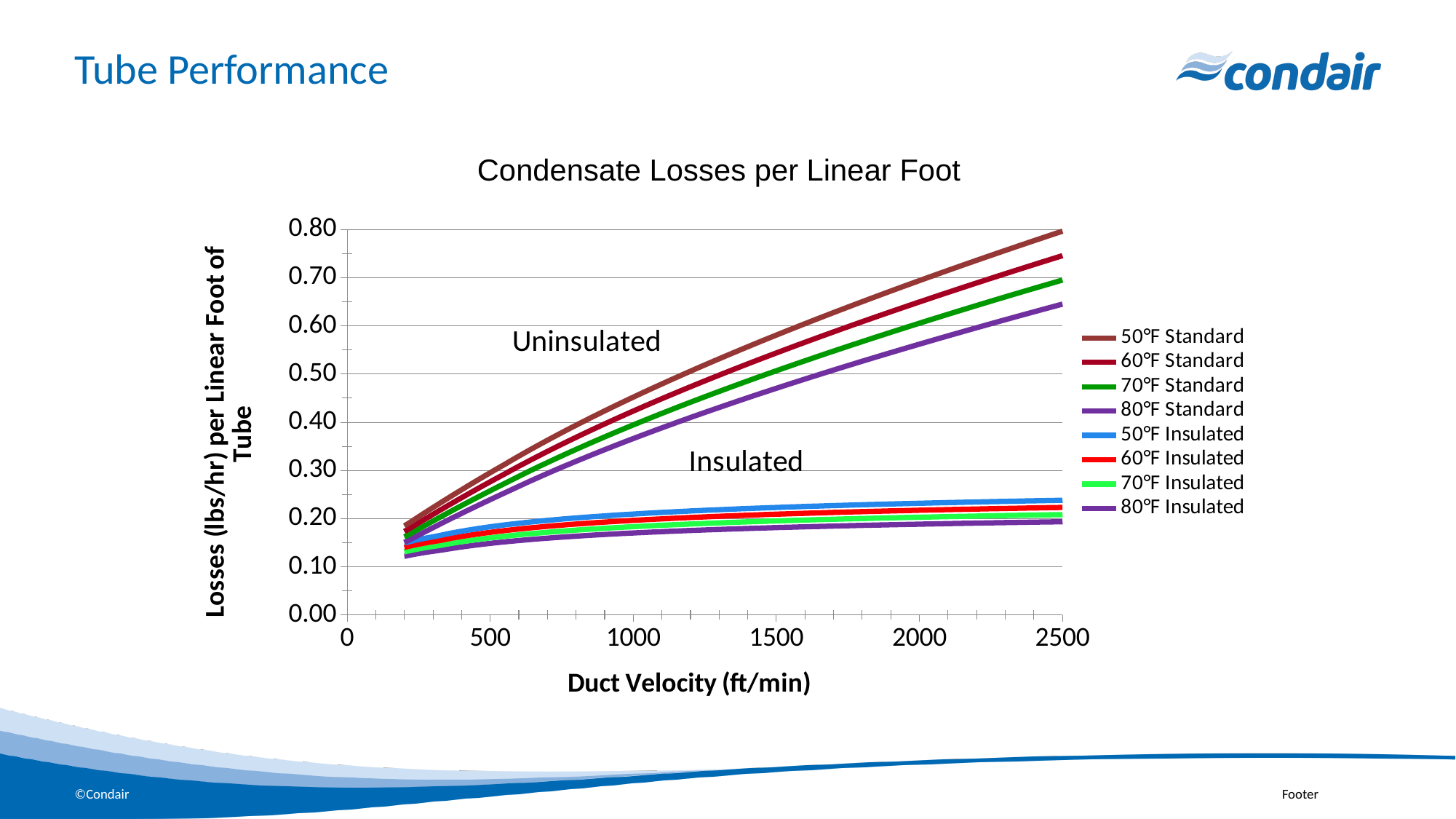
How many series does the legend list? 8 What is the label of the x axis? Duct Velocity (ft/min) Do the values for 50°F Standard rise or fall as duct velocity increases? rise What kind of chart is shown on the slide? line chart Is the value for 50°F Insulated at 2500 ft/min greater or less than 0.30? less Which series has the lowest value at 2500 ft/min? 80°F Insulated Is the value for 80°F Standard at 2500 ft/min greater or less than 0.60? greater Is the value for 70°F Standard at 1000 ft/min greater or less than 0.30? greater Which series has the highest value at 2500 ft/min? 50°F Standard At 2500 ft/min, which is larger: 50°F Standard or 50°F Insulated? 50°F Standard What is the title of the chart? Condensate Losses per Linear Foot